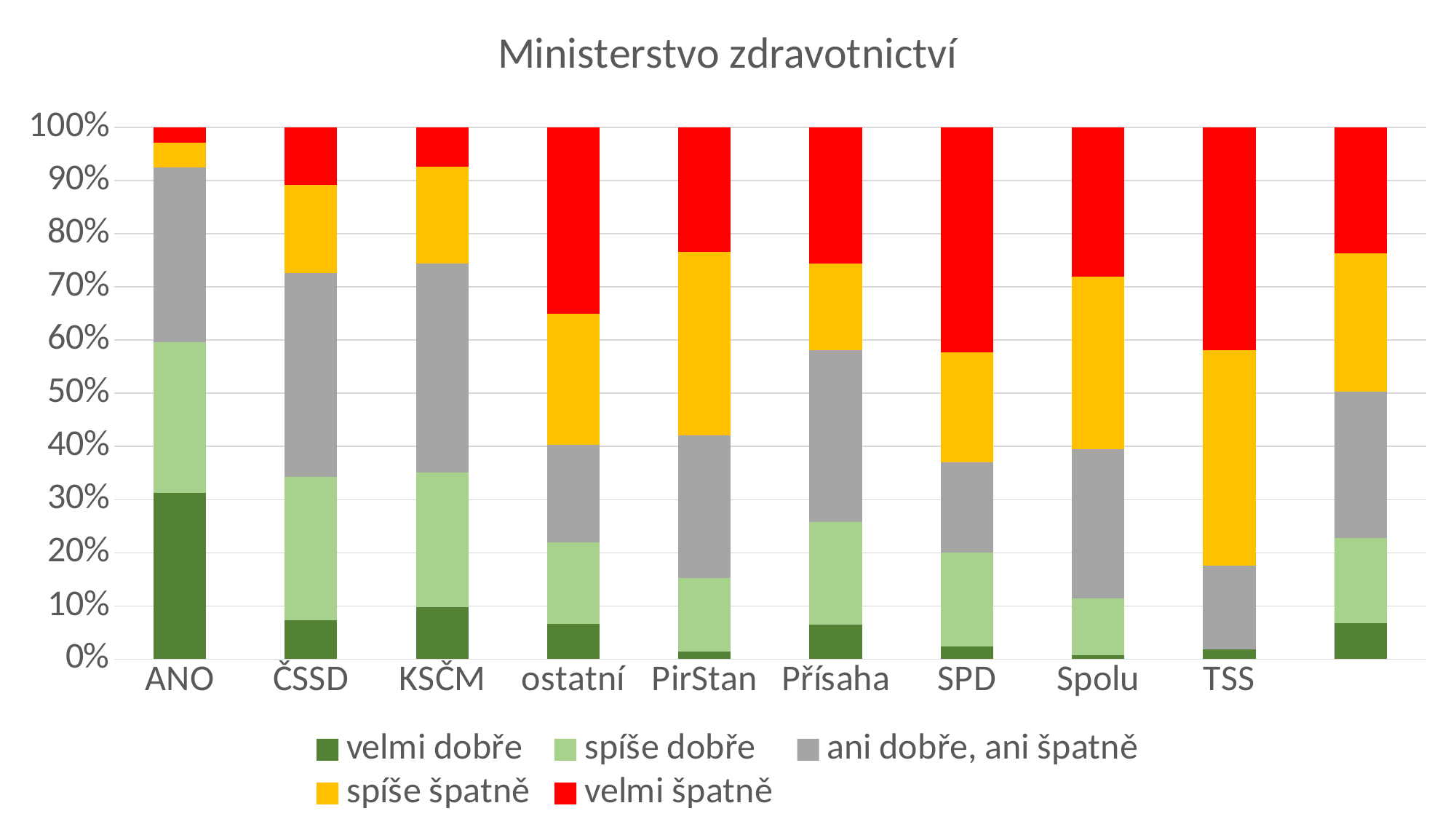
What is the title of the chart? Ministerstvo zdravotnictví Is the "velmi dobře" value for ANO greater or less than 20%? greater How many series does the legend list? 5 Which is larger: the "velmi špatně" segment for ANO or for ostatní? ostatní Which colour represents the series "velmi špatně" in the legend? red Is the "velmi špatně" value for ostatní greater or less than 30%? greater Which category has the largest "spíše špatně" segment? TSS Which is larger: the "velmi dobře" segment for ANO or for ČSSD? ANO What kind of chart is shown on the slide? stacked bar chart Is the "velmi dobře" value for ČSSD greater or less than 10%? less Which category has the largest "velmi dobře" segment? ANO